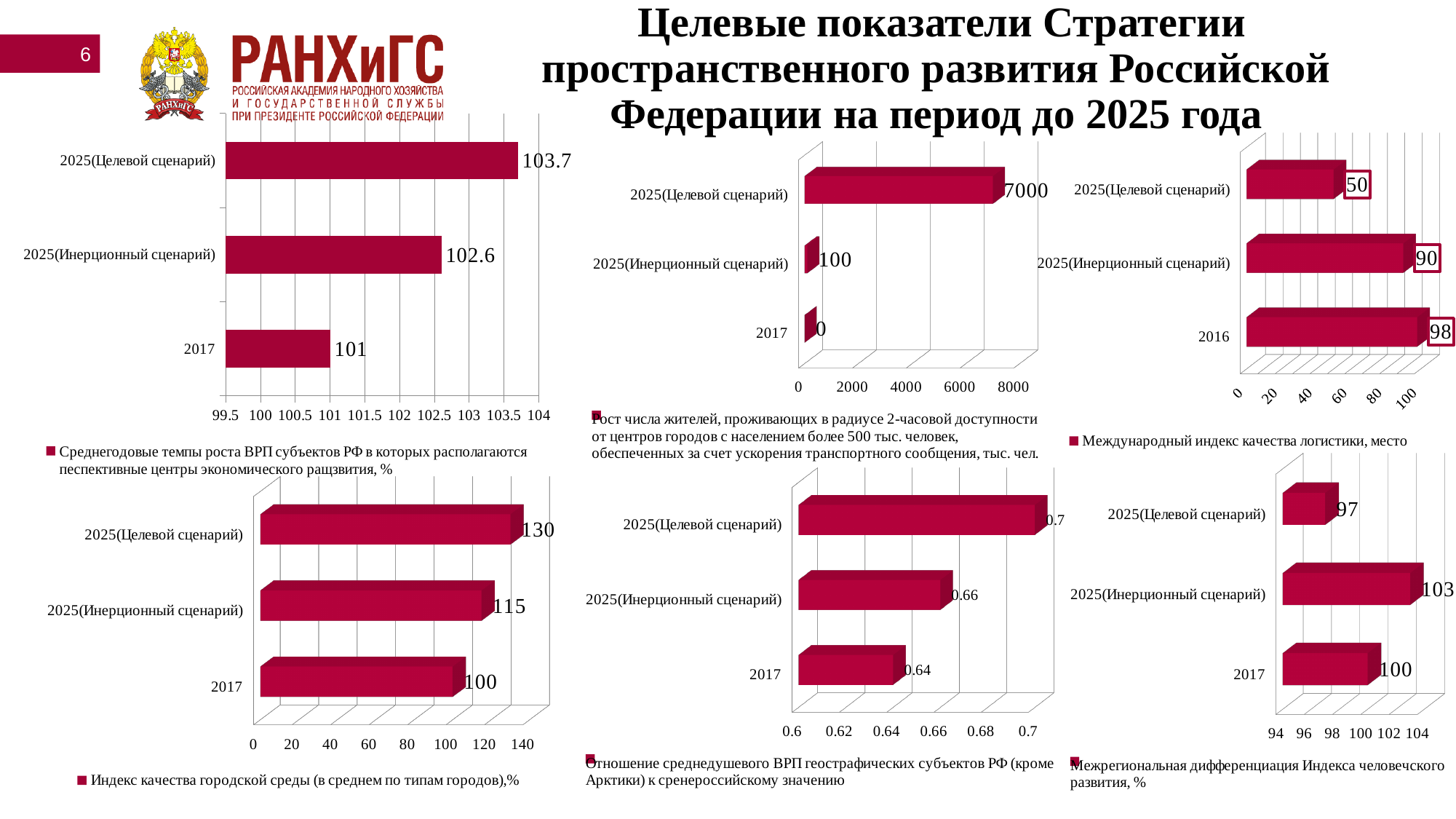
In the top-left chart (average annual GRP growth rates), what is the value for 2017? 101 How many charts are shown on the slide? 6 In the bottom-right chart (interregional differentiation of the Human Development Index), is the value for 2025(Целевой сценарий) larger or smaller than the value for 2017? smaller In the top-middle chart (growth in number of residents within 2-hour accessibility), what is the difference between 2025(Целевой сценарий) and 2025(Инерционный сценарий)? 6900 In the top-right chart (international logistics quality index), which category has the lowest value? 2025(Целевой сценарий) In the top-middle chart (growth in number of residents within 2-hour accessibility), what is the value for 2025(Целевой сценарий)? 7000 In the bottom-left chart (urban environment quality index), what is the value for 2025(Инерционный сценарий)? 115 In the bottom-middle chart (ratio of per capita GRP to the Russian average), what is the value for 2017? 0.64 In the top-left chart (average annual GRP growth rates), what is the value for 2025(Целевой сценарий)? 103.7 In the bottom-left chart (urban environment quality index), what is the difference between 2025(Целевой сценарий) and 2017? 30 In the bottom-right chart (interregional differentiation of the Human Development Index), which category has the highest value? 2025(Инерционный сценарий) In the top-right chart (international logistics quality index), what is the value for 2016? 98